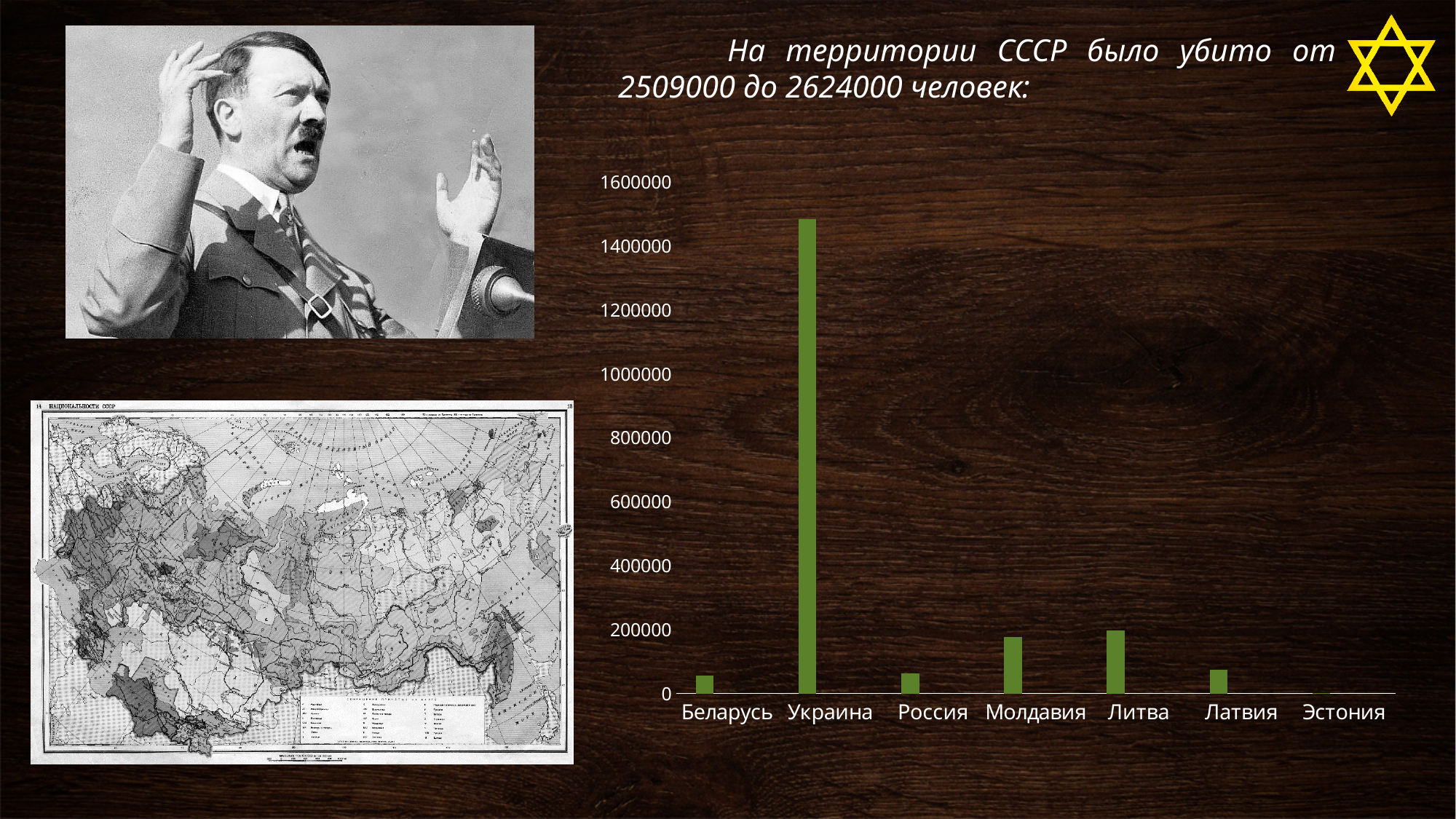
Which is larger, the value for Украина or the value for Молдавия? Украина Is the value for Молдавия greater or less than 200000? less Which is larger, the value for Молдавия or the value for Беларусь? Молдавия Which is larger, the value for Литва or the value for Латвия? Литва What colour are the bars in the chart? green Is the value for Беларусь greater or less than 200000? less What kind of chart is shown on the slide? bar chart Which category has the lowest bar in the chart? Эстония Is the value for Латвия greater or less than 200000? less Which category has the highest bar in the chart? Украина How many categories are shown on the x axis of the chart? 7